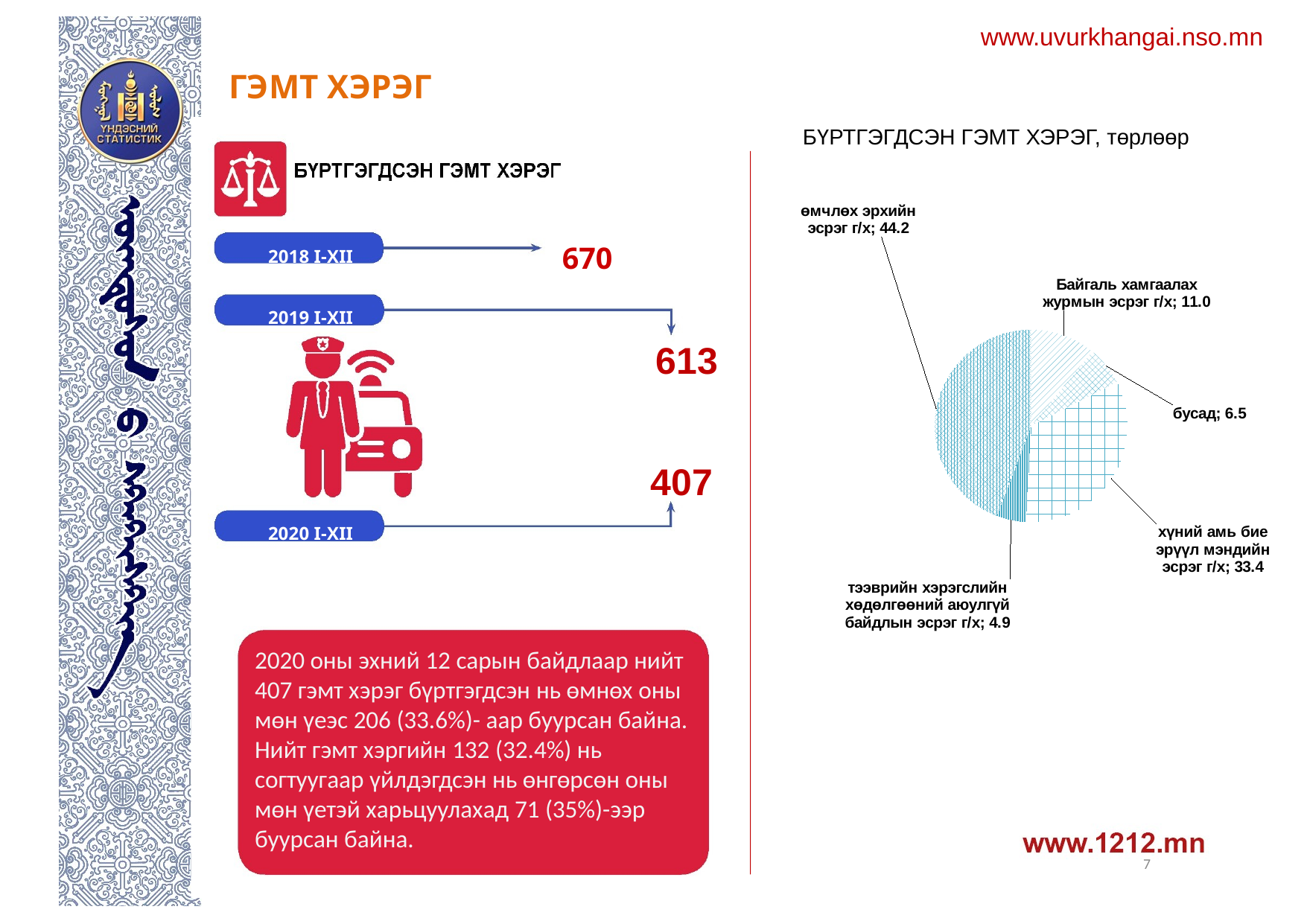
In the pie chart 'БҮРТГЭГДСЭН ГЭМТ ХЭРЭГ, төрлөөр', which category has the largest slice? өмчлөх эрхийн эсрэг г/х In the pie chart 'БҮРТГЭГДСЭН ГЭМТ ХЭРЭГ, төрлөөр', what is the value for 'хүний амь бие эрүүл мэндийн эсрэг г/х'? 33.4 In the pie chart 'БҮРТГЭГДСЭН ГЭМТ ХЭРЭГ, төрлөөр', how many slices are there? 5 In the pie chart 'БҮРТГЭГДСЭН ГЭМТ ХЭРЭГ, төрлөөр', which category has the smallest slice? тээврийн хэрэгслийн хөдөлгөөний аюулгүй байдлын эсрэг г/х In the 'БҮРТГЭГДСЭН ГЭМТ ХЭРЭГ' infographic on the left of the slide, do the values rise or fall from 2018 to 2020? Fall In the pie chart 'БҮРТГЭГДСЭН ГЭМТ ХЭРЭГ, төрлөөр', what is the value for 'Байгаль хамгаалах журмын эсрэг г/х'? 11.0 In the pie chart 'БҮРТГЭГДСЭН ГЭМТ ХЭРЭГ, төрлөөр', what is the value for 'өмчлөх эрхийн эсрэг г/х'? 44.2 In the 'БҮРТГЭГДСЭН ГЭМТ ХЭРЭГ' infographic on the left of the slide, what is the value for 2019 I-XII? 613 In the pie chart 'БҮРТГЭГДСЭН ГЭМТ ХЭРЭГ, төрлөөр', what is the value for 'бусад'? 6.5 In the pie chart 'БҮРТГЭГДСЭН ГЭМТ ХЭРЭГ, төрлөөр', which is larger: 'Байгаль хамгаалах журмын эсрэг г/х' or 'бусад'? Байгаль хамгаалах журмын эсрэг г/х In the pie chart 'БҮРТГЭГДСЭН ГЭМТ ХЭРЭГ, төрлөөр', what is the difference between the values for 'өмчлөх эрхийн эсрэг г/х' and 'хүний амь бие эрүүл мэндийн эсрэг г/х'? 10.8 What kind of chart is the 'БҮРТГЭГДСЭН ГЭМТ ХЭРЭГ, төрлөөр' chart on the right of the slide? Pie chart